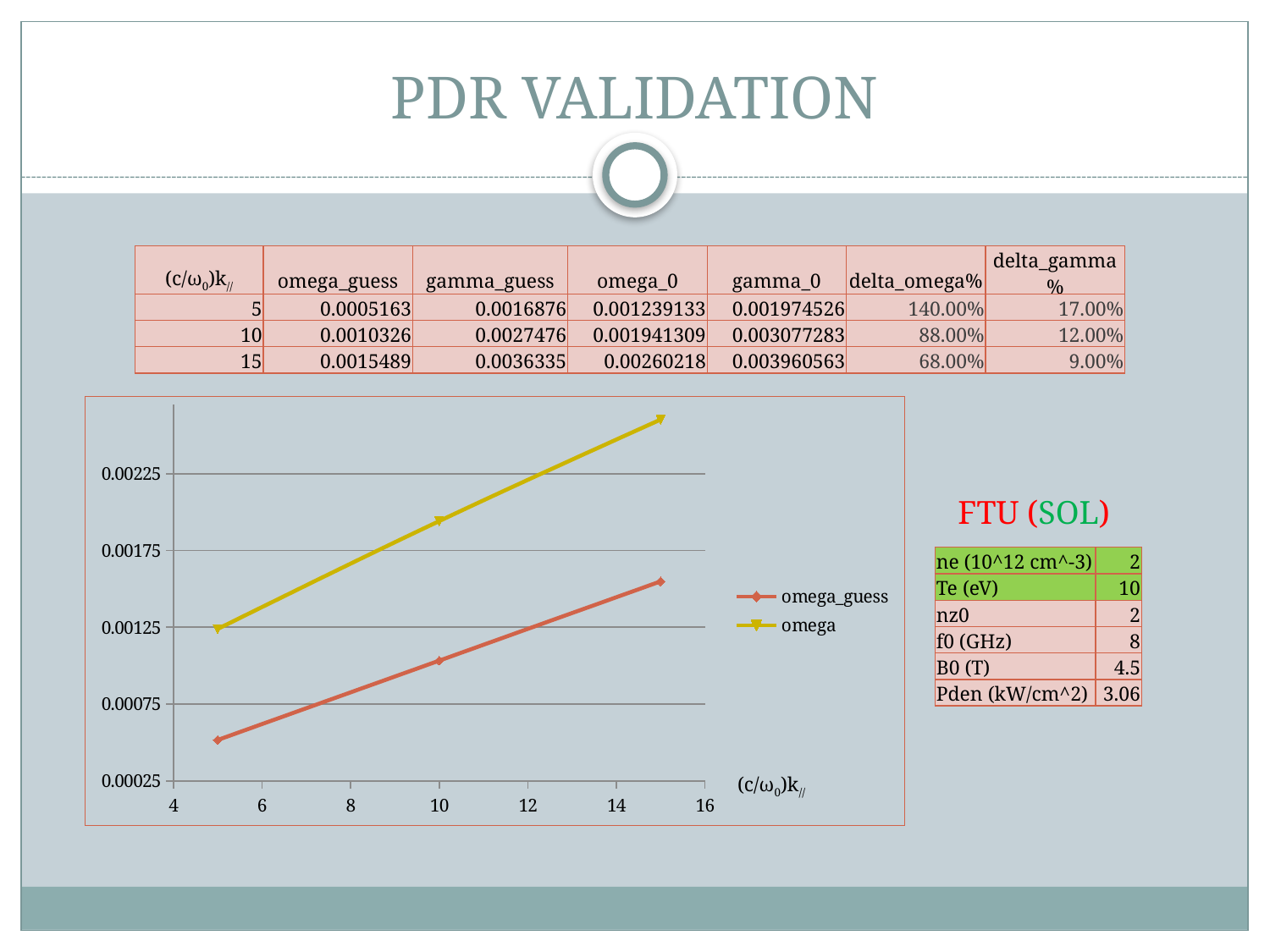
Is the value of omega at (c/ω0)k// = 10 greater or less than 0.00175? greater Which series has the higher value at (c/ω0)k// = 10, omega_guess or omega? omega Is the value of omega_guess at (c/ω0)k// = 15 greater or less than 0.00175? less Is the value of omega_guess at (c/ω0)k// = 5 greater or less than 0.00075? less How many data points does each line in the chart have? 3 Do the values of the omega_guess series rise or fall along the x axis? rise What are the names of the two series in the chart legend? omega_guess and omega What colour is the omega line in the chart? yellow Do the values of the omega series rise or fall as (c/ω0)k// increases? rise How many series does the chart legend list? 2 What kind of chart is shown on the slide? line chart